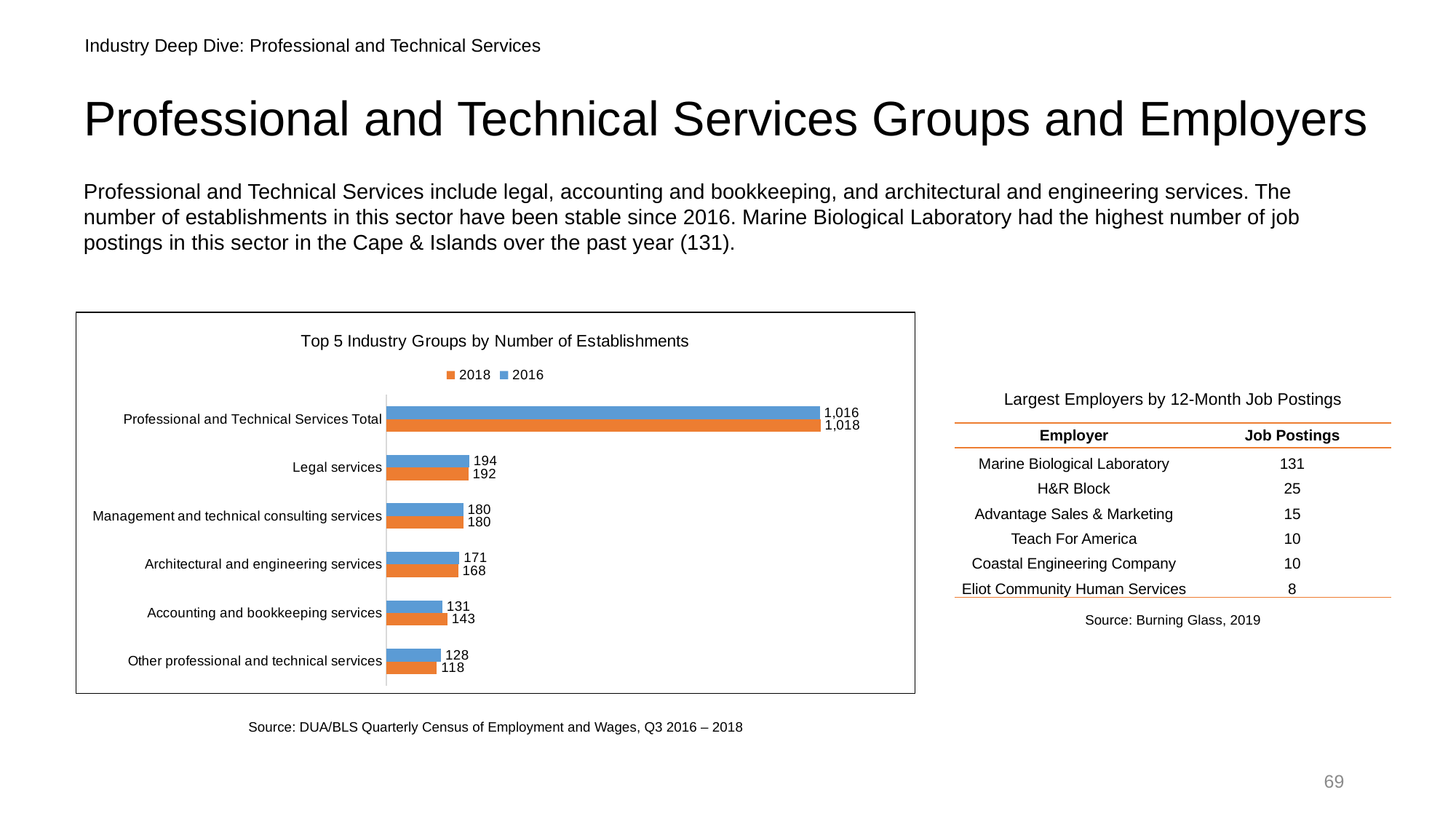
How many categories are plotted on the chart? 6 What is the title of the chart? Top 5 Industry Groups by Number of Establishments Excluding the total, which industry group has the highest number of establishments in 2016? Legal services What is the 2018 value for Legal services? 192 Which is larger for Other professional and technical services, the 2016 value or the 2018 value? 2016 How many series does the legend of the chart list? 2 What is the difference between the 2018 and 2016 values for Accounting and bookkeeping services? 12 What is the 2018 value for Professional and Technical Services Total? 1,018 What kind of chart is shown on the slide? bar chart What is the 2016 value for Accounting and bookkeeping services? 131 Which industry group has the lowest number of establishments in 2018? Other professional and technical services What is the 2016 value for Management and technical consulting services? 180